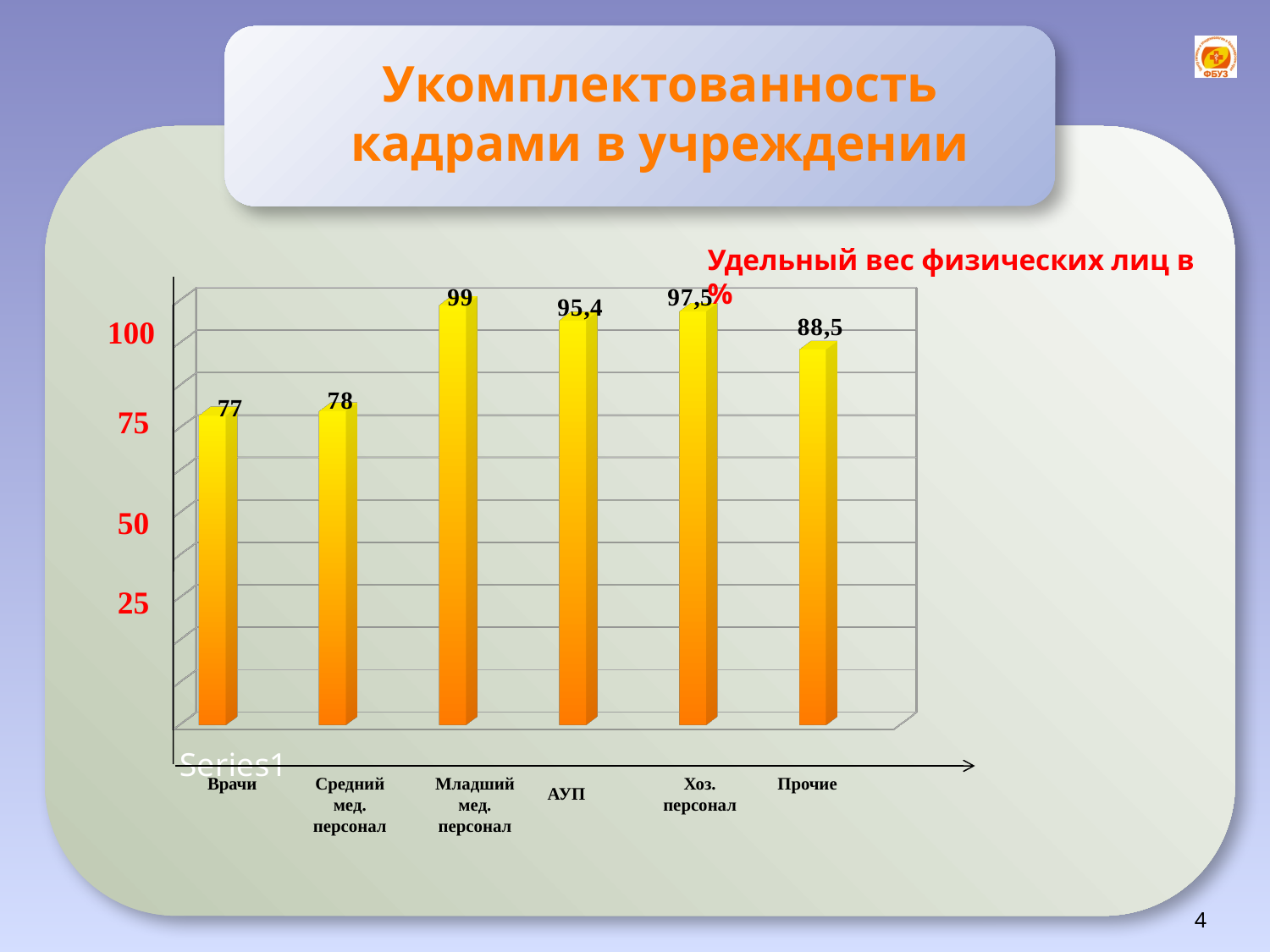
Which category has the highest value? Младший мед. персонал Which category has the lowest value? Врачи What is the value for Врачи? 77 What is the value for Младший мед. персонал? 99 What is the title of the slide? Укомплектованность кадрами в учреждении What kind of chart is shown on the slide? bar chart Is the value for Средний мед. персонал greater or less than 75? greater How many categories are shown on the x axis? 6 What is the difference between the values for Хоз. персонал and Прочие? 9 What is the value for АУП? 95,4 What is the value for Прочие? 88,5 Which is larger, the value for АУП or the value for Хоз. персонал? Хоз. персонал